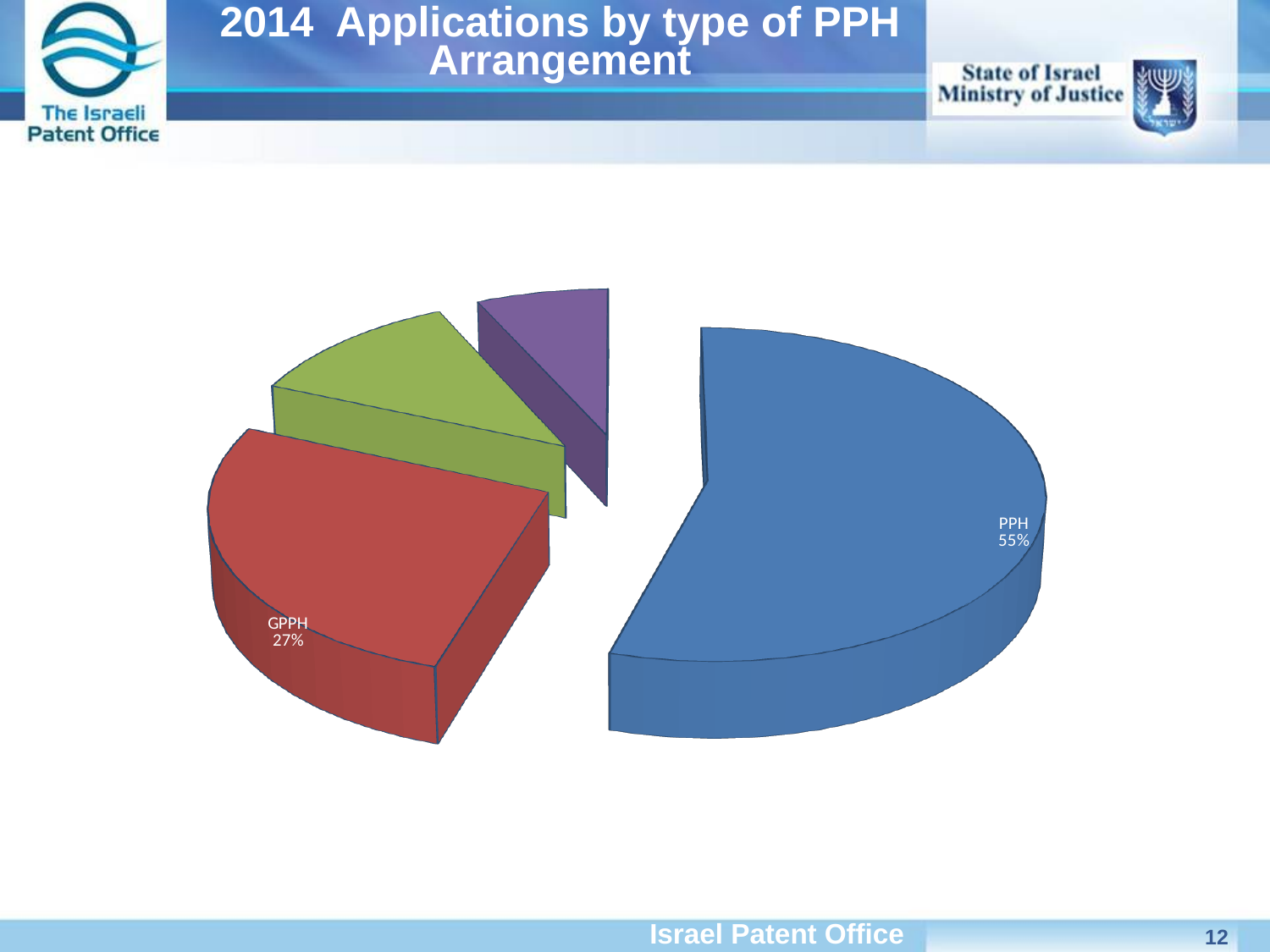
Which labelled slice of the pie is the largest? PPH What kind of chart is shown on the slide? pie chart Which is larger, the PPH slice or the GPPH slice? PPH How many slices does the pie chart have? 4 What is the title of the slide? 2014 Applications by type of PPH Arrangement What percentage of 2014 applications were under the GPPH arrangement? 27% What percentage of 2014 applications were under the PPH arrangement? 55% What colour is the PPH slice of the pie? blue By how many percentage points does the PPH share exceed the GPPH share? 28 percentage points What share of the pie does the PPH slice represent? 55%